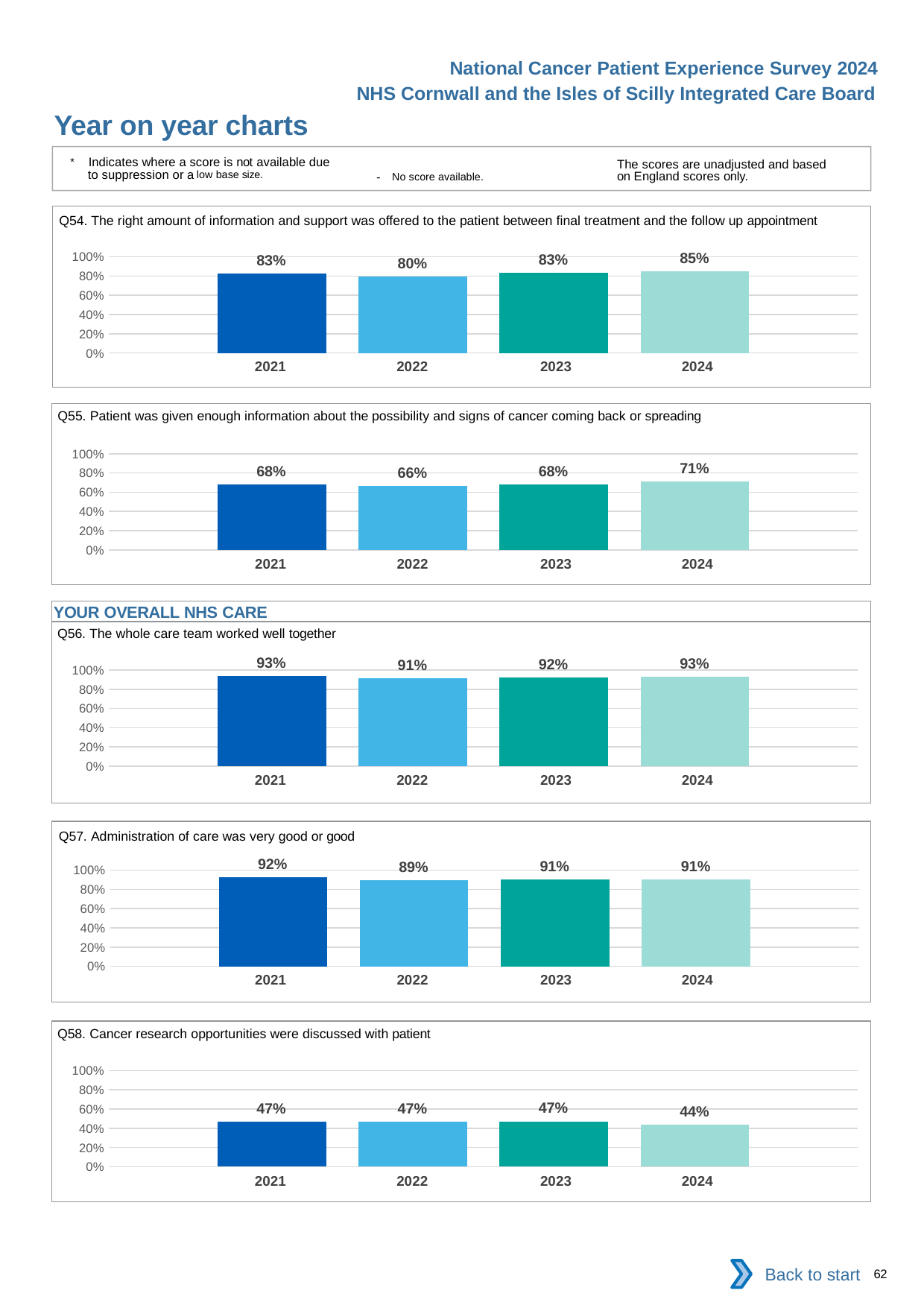
In the Q55 chart, which year has the lowest value? 2022 How many charts are shown on the slide? 5 In the Q57 chart, is the value for 2022 larger or smaller than the value for 2023? smaller In the Q58 chart, is the value for 2021 greater or less than 60%? less In the Q55 chart, what is the difference between the 2024 value and the 2021 value? 3% In the Q56 chart, what is the value for 2022? 91% What kind of chart is the Q56 chart? bar chart In the Q54 chart, what is the difference between the 2024 value and the 2022 value? 5% In the Q54 chart, what is the value for 2024? 85% In the Q57 chart, which year has the highest value? 2021 In the Q58 chart, what is the value for 2024? 44% How many years are shown in the Q54 chart? 4